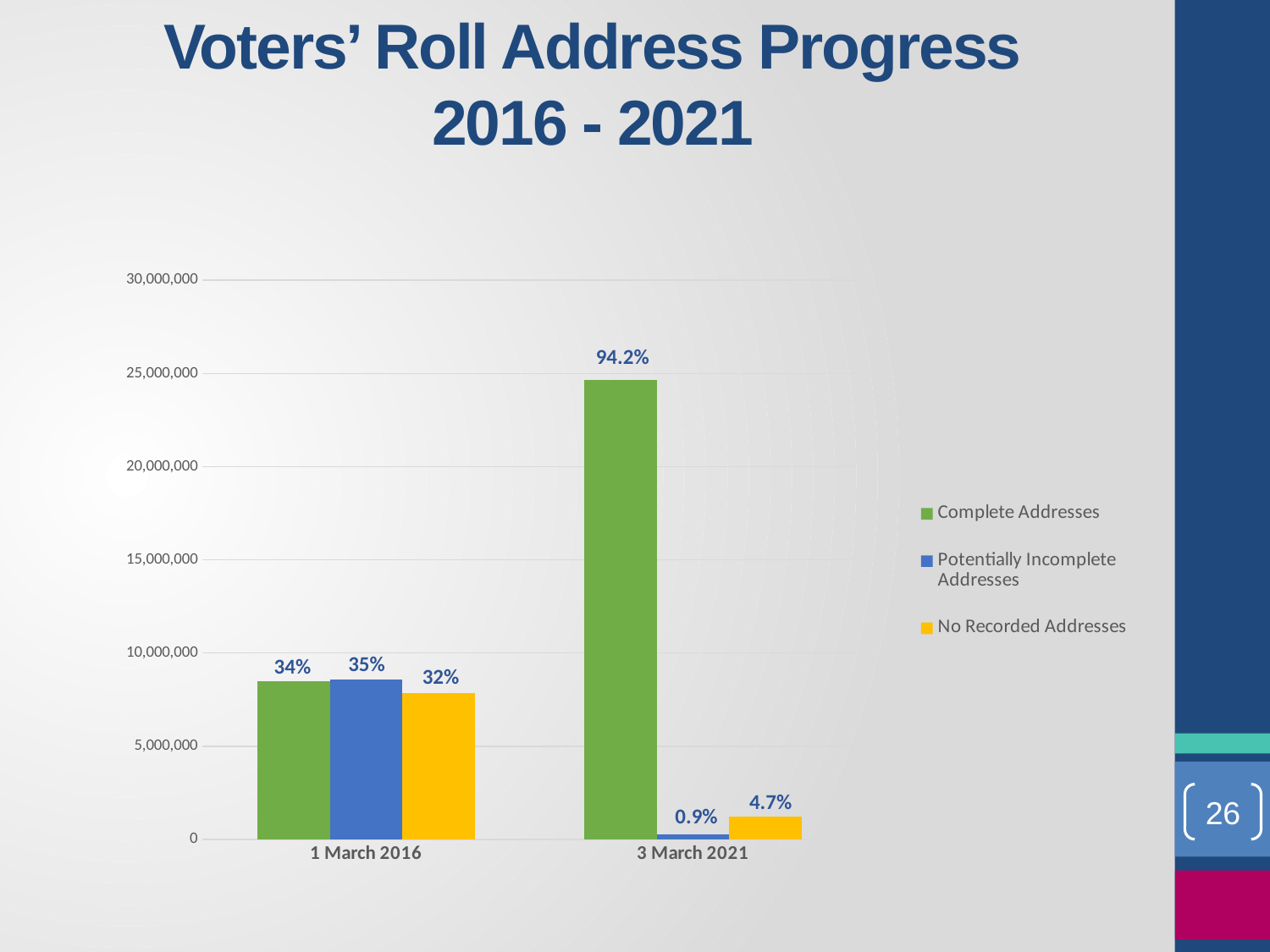
What data label is shown on the Potentially Incomplete Addresses bar for 3 March 2021? 0.9% Which series has the tallest bar for 3 March 2021? Complete Addresses What data label is shown on the Complete Addresses bar for 3 March 2021? 94.2% How many series does the legend list? 3 Which series has the shortest bar for 3 March 2021? Potentially Incomplete Addresses What is the title of the chart on the slide? Voters' Roll Address Progress 2016 - 2021 What kind of chart is shown on the slide? Bar chart What data label is shown on the No Recorded Addresses bar for 3 March 2021? 4.7% Is the Complete Addresses bar for 1 March 2016 greater or less than 10,000,000? less Is the Complete Addresses bar for 3 March 2021 greater or less than 20,000,000? greater What data label is shown on the Potentially Incomplete Addresses bar for 1 March 2016? 35% How many date categories are shown on the x axis? 2